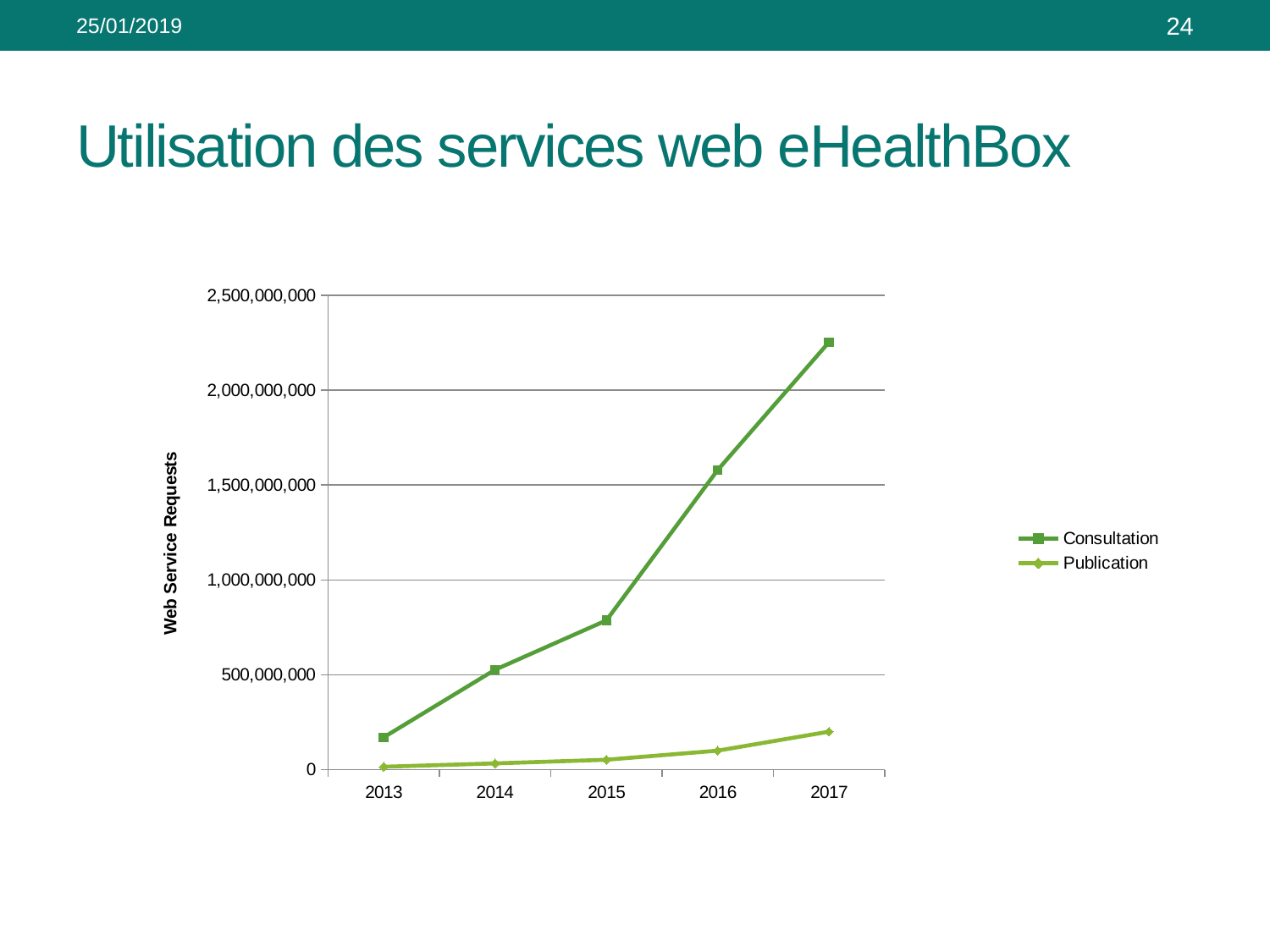
How many series does the legend list? 2 Is the value for Publication in 2017 greater or less than 500,000,000? less Which series is shown in the legend with square markers? Consultation Which series has the larger value in 2016, Consultation or Publication? Consultation How many years are plotted along the x axis? 5 What is the label of the vertical axis? Web Service Requests In which year is the Consultation series highest? 2017 What kind of chart is shown on the slide? line chart In which year is the Consultation series lowest? 2013 Is the value for Consultation in 2017 greater or less than 2,000,000,000? greater Is the value for Consultation in 2016 greater or less than 1,500,000,000? greater